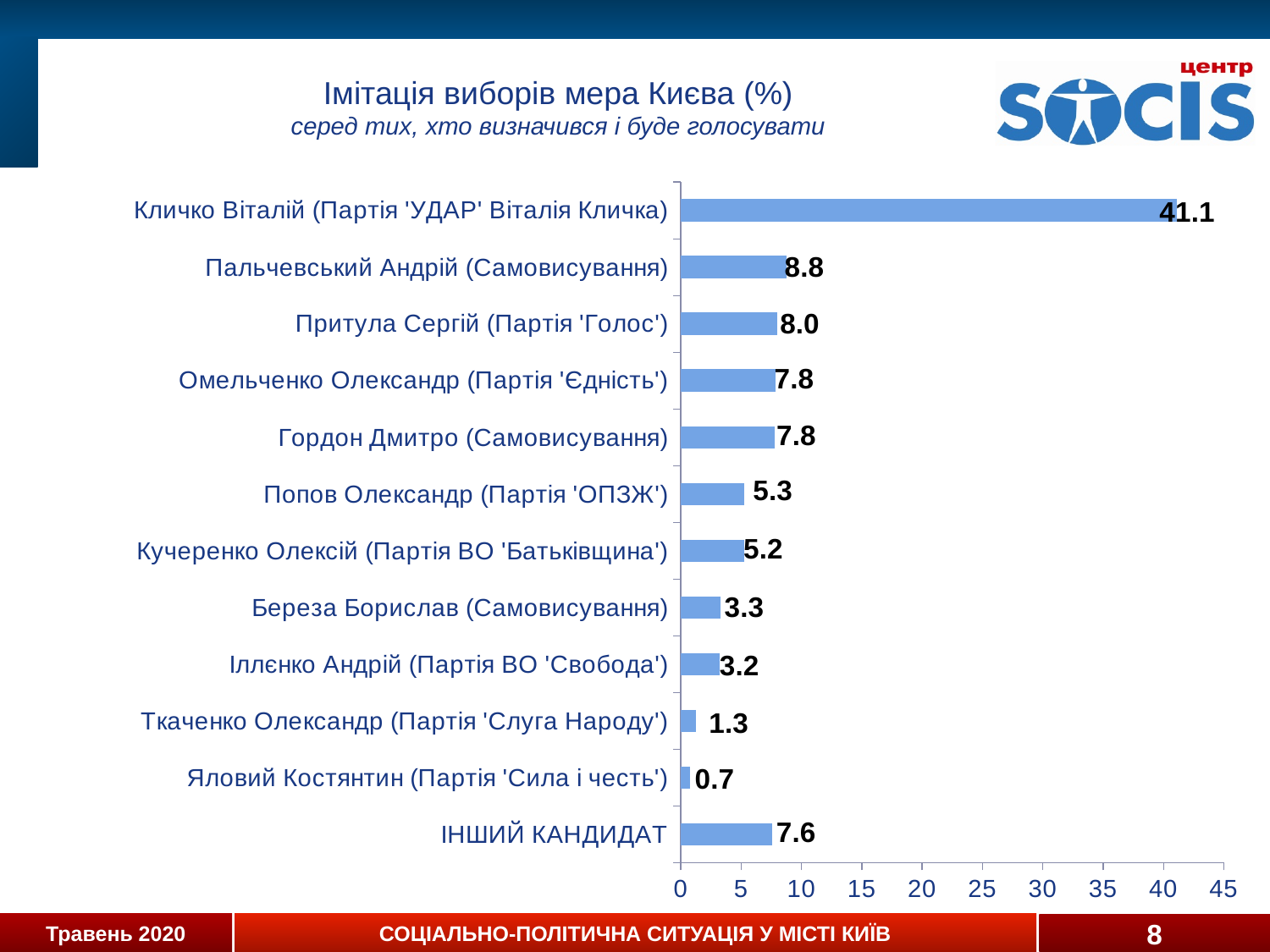
What is the difference between the values for Кличко Віталій and Пальчевський Андрій? 32.3 Is the value for Кличко Віталій greater or less than 40? greater What is the value for Ткаченко Олександр (Партія 'Слуга Народу')? 1.3 How many categories are shown in the chart? 12 Which candidate has the lowest value? Яловий Костянтин (Партія 'Сила і честь') What is the value for Пальчевський Андрій (Самовисування)? 8.8 What is the value for Кличко Віталій (Партія 'УДАР' Віталія Кличка)? 41.1 What is the title of the chart? Імітація виборів мера Києва (%) What is the value for ІНШИЙ КАНДИДАТ? 7.6 Which is larger: the value for Притула Сергій (Партія 'Голос') or the value for Попов Олександр (Партія 'ОПЗЖ')? Притула Сергій (Партія 'Голос') Which candidate has the highest value? Кличко Віталій (Партія 'УДАР' Віталія Кличка) What kind of chart is shown on the slide? bar chart